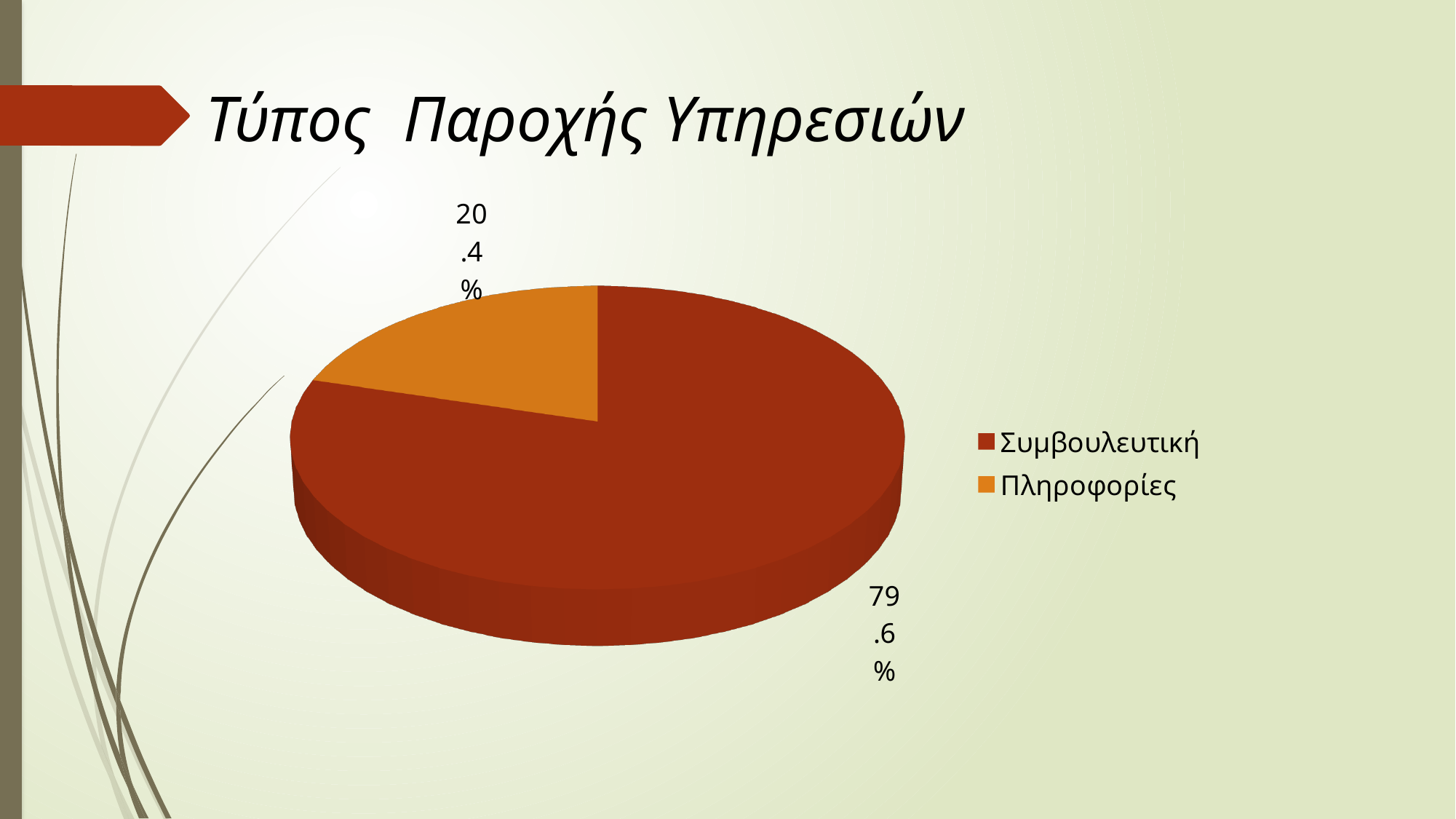
What colour is the Πληροφορίες slice? Orange What is the title of the slide? Τύπος Παροχής Υπηρεσιών Which category has the largest slice of the pie? Συμβουλευτική What share of the pie does Πληροφορίες represent? 20.4% How many categories does the pie chart show? 2 How many entries does the legend list? 2 What kind of chart is shown on the slide? Pie chart Which slice is larger, Συμβουλευτική or Πληροφορίες? Συμβουλευτική What is the difference in percentage points between the Συμβουλευτική and Πληροφορίες slices? 59.2 What share of the pie does Συμβουλευτική represent? 79.6% Which category has the smallest slice of the pie? Πληροφορίες